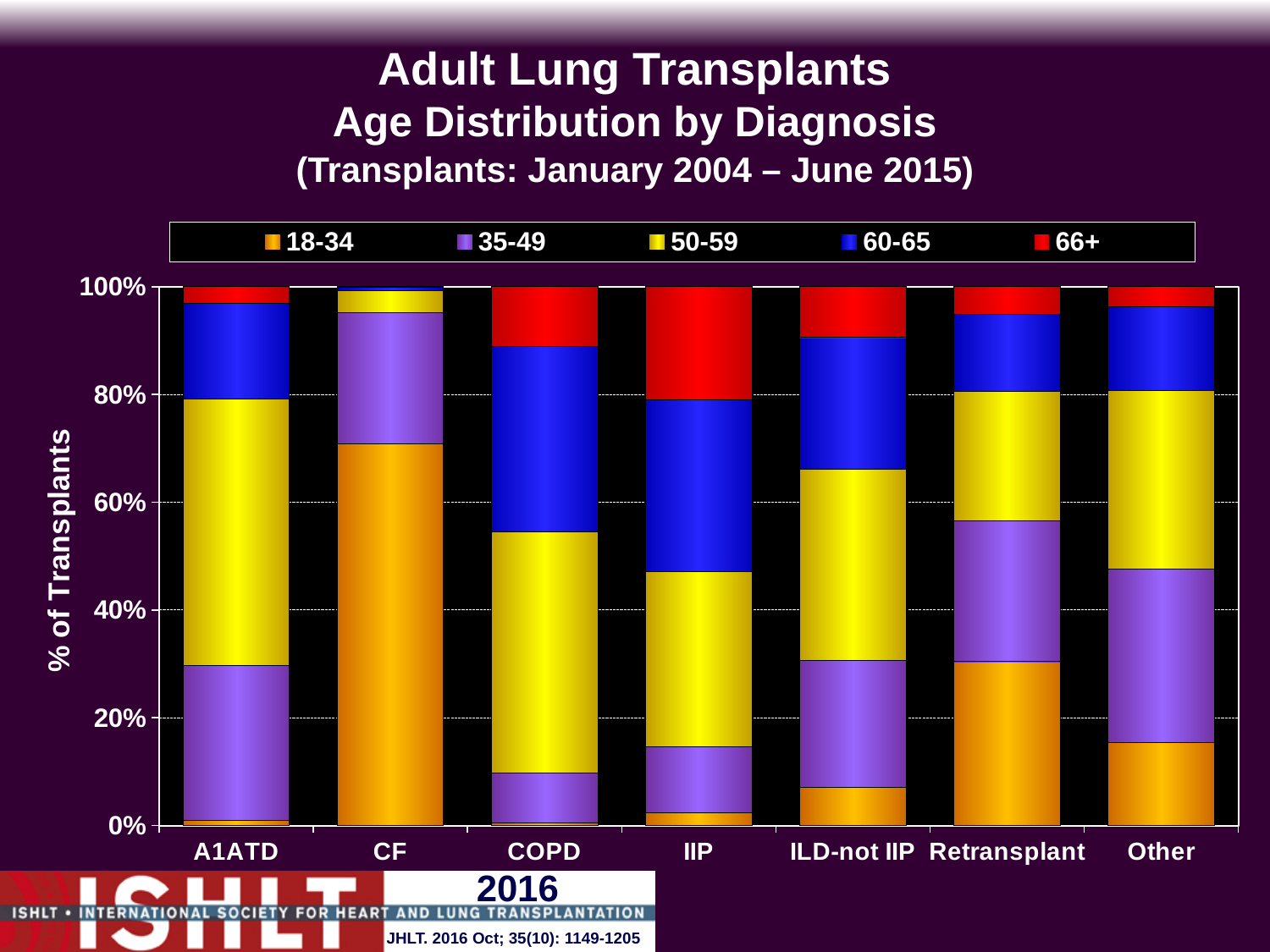
Is the 18-34 share for A1ATD greater or less than 20%? less What kind of chart is shown on the slide? Stacked bar chart How many age groups does the legend list? 5 Is the 66+ share larger for IIP or for CF? IIP What is the label on the y axis of the chart? % of Transplants Is the 18-34 share for CF greater or less than 60%? greater How many diagnosis categories are shown on the x axis? 7 Which diagnosis has the largest share of transplants in the 66+ age group? IIP Is the 18-34 share larger for CF or for COPD? CF Is the 66+ share for IIP greater or less than 10%? greater Which diagnosis has the largest share of transplants in the 18-34 age group? CF